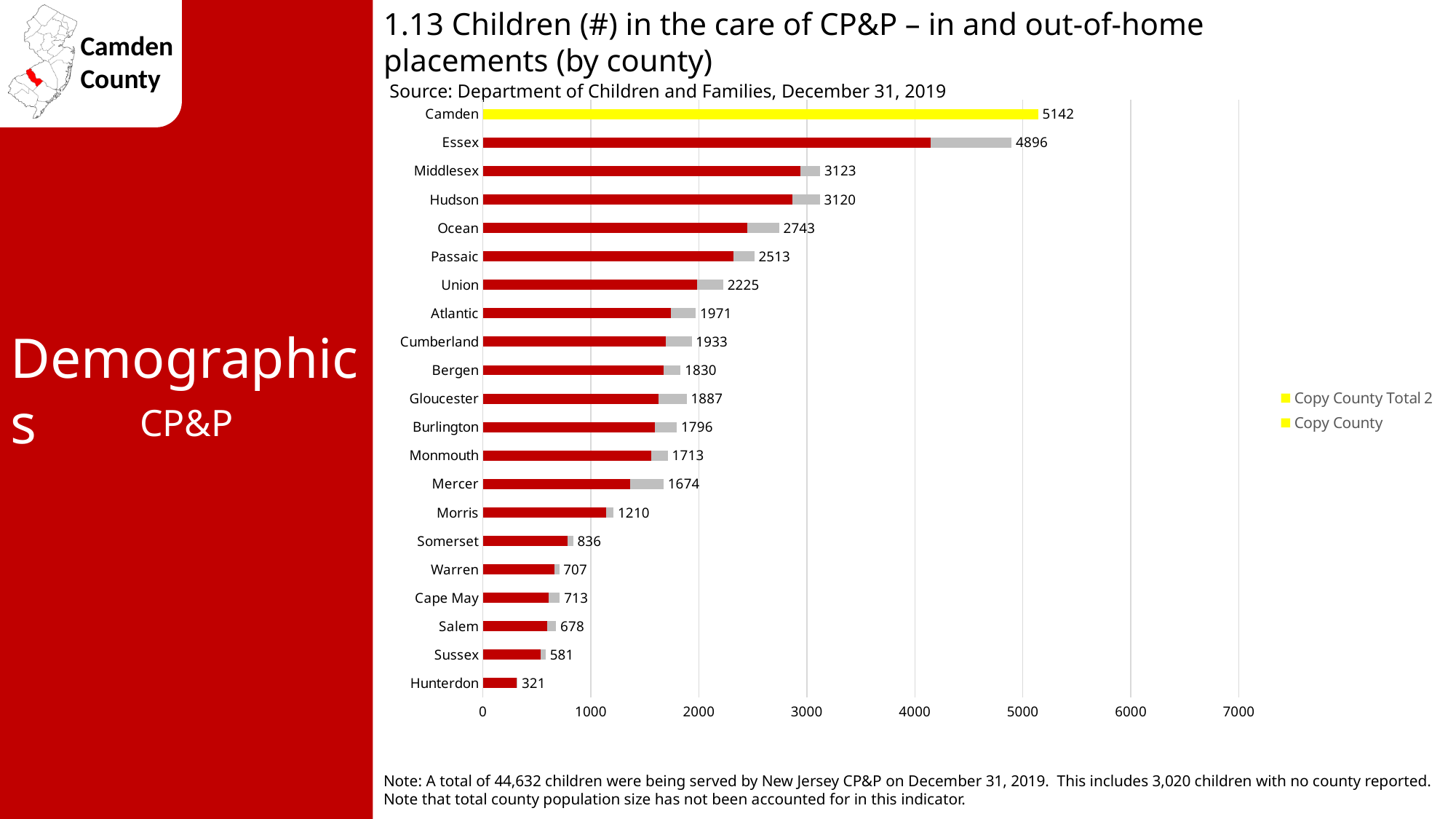
What is the source cited for the chart data? Department of Children and Families, December 31, 2019 What is the difference between the totals for Camden and Essex? 246 What kind of chart is shown on the slide? Bar chart How many counties are shown on the chart? 21 What is the total number of children in the care of CP&P for Camden County? 5142 What is the total value shown for Hunterdon County? 321 Which county has the highest total number of children in the care of CP&P? Camden How many entries does the legend list? 2 Which county has a larger total, Ocean or Passaic? Ocean Is the total value for Union County greater or less than 2000? greater What is the total value shown for Essex County? 4896 Which county has the lowest total number of children in the care of CP&P? Hunterdon